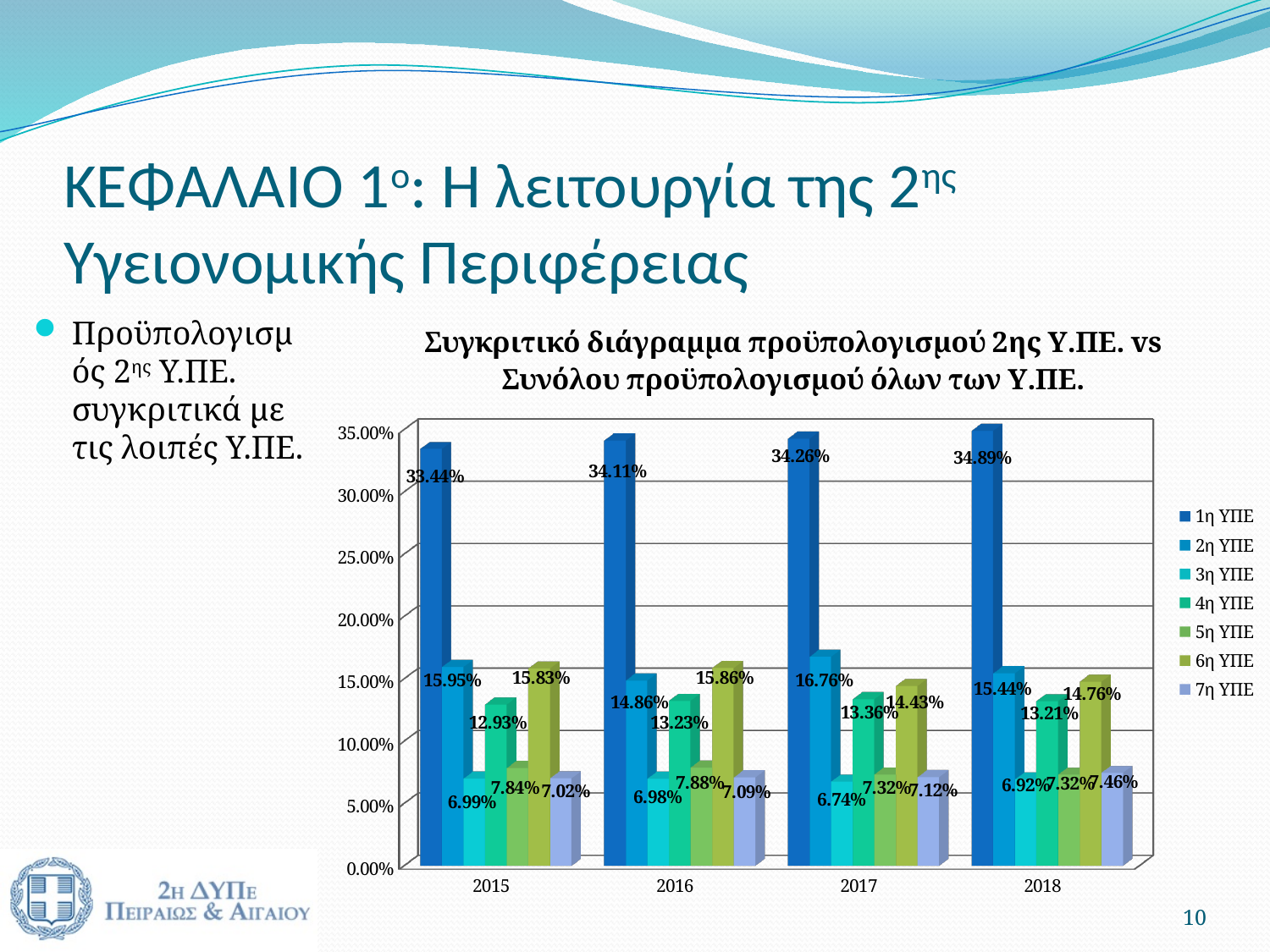
Which series has the lowest value in 2018? 3η ΥΠΕ Which is larger in 2016: the value for 2η ΥΠΕ or the value for 6η ΥΠΕ? 6η ΥΠΕ Which series has the highest value in 2017? 1η ΥΠΕ What is the value for 2η ΥΠΕ in 2017? 16.76% Does the value for 1η ΥΠΕ rise or fall from 2015 to 2018? Rise What is the value for 6η ΥΠΕ in 2016? 15.86% How many series does the legend list? 7 What is the value for 1η ΥΠΕ in 2018? 34.89% What is the difference between the 1η ΥΠΕ values in 2018 and 2015? 1.45% How many years are shown on the x axis? 4 What is the value for 3η ΥΠΕ in 2015? 6.99% What kind of chart is shown on the slide? Bar chart